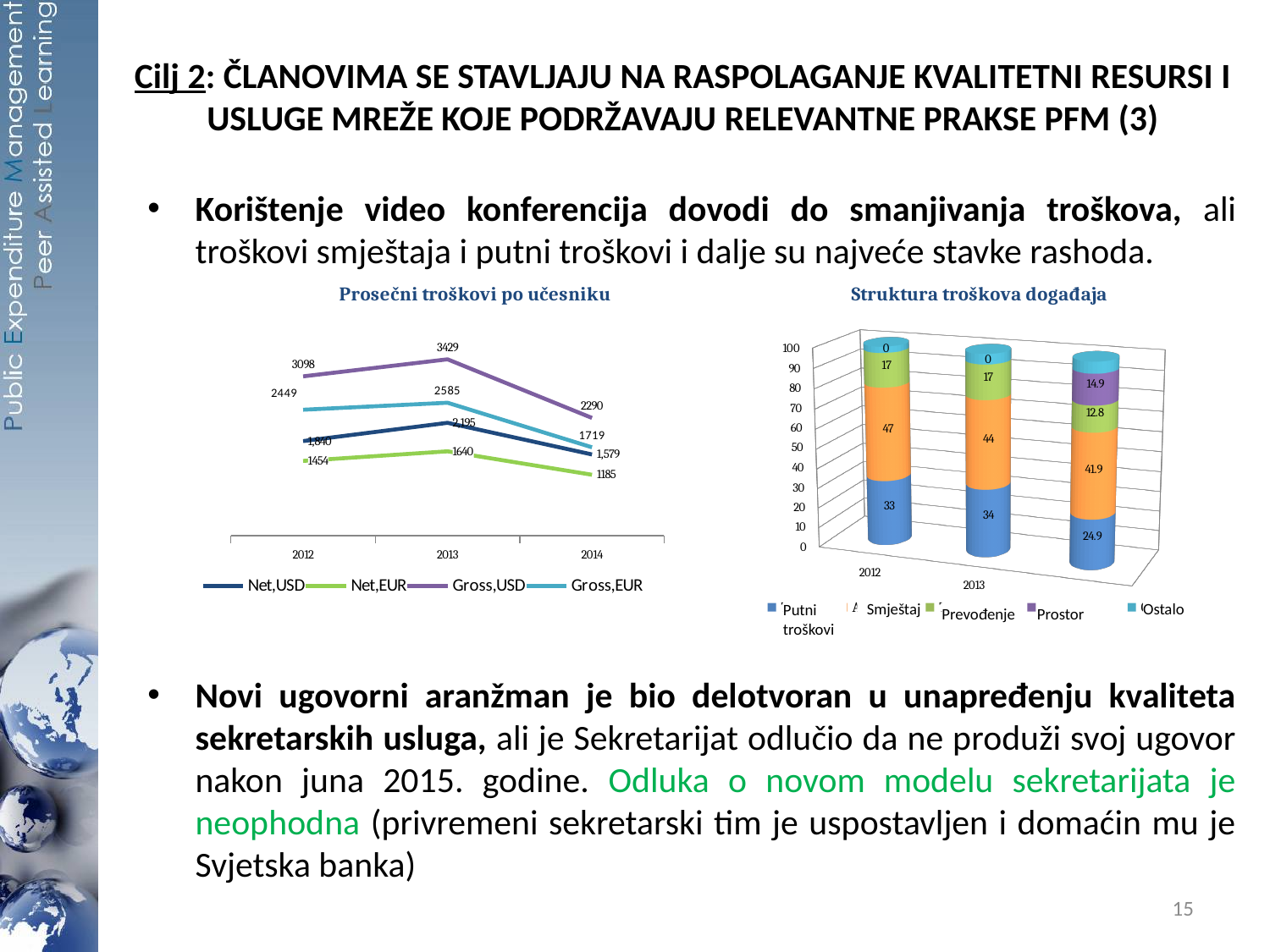
In the chart titled "Struktura troškova događaja", what is the value for Putni troškovi in 2013? 34 In the chart titled "Prosečni troškovi po učesniku", does Gross,EUR rise or fall from 2013 to 2014? Fall In the chart titled "Prosečni troškovi po učesniku", in which year is Gross,USD highest? 2013 How many series does the legend of the chart titled "Prosečni troškovi po učesniku" list? 4 In the chart titled "Prosečni troškovi po učesniku", what is the Net,EUR value for 2014? 1185 In the chart titled "Struktura troškova događaja", is the Smještaj value larger in 2012 or in 2013? 2012 In the chart titled "Struktura troškova događaja", what is the value for Smještaj in 2012? 47 In the chart titled "Prosečni troškovi po učesniku", what is the Gross,USD value for 2013? 3429 What kind of chart is the one titled "Prosečni troškovi po učesniku"? Line chart In the chart titled "Prosečni troškovi po učesniku", by how much did Gross,USD fall from 2013 to 2014? 1139 In the chart titled "Prosečni troškovi po učesniku", what is the Net,USD value for 2012? 1,840 How many series does the legend of the chart titled "Struktura troškova događaja" list? 5